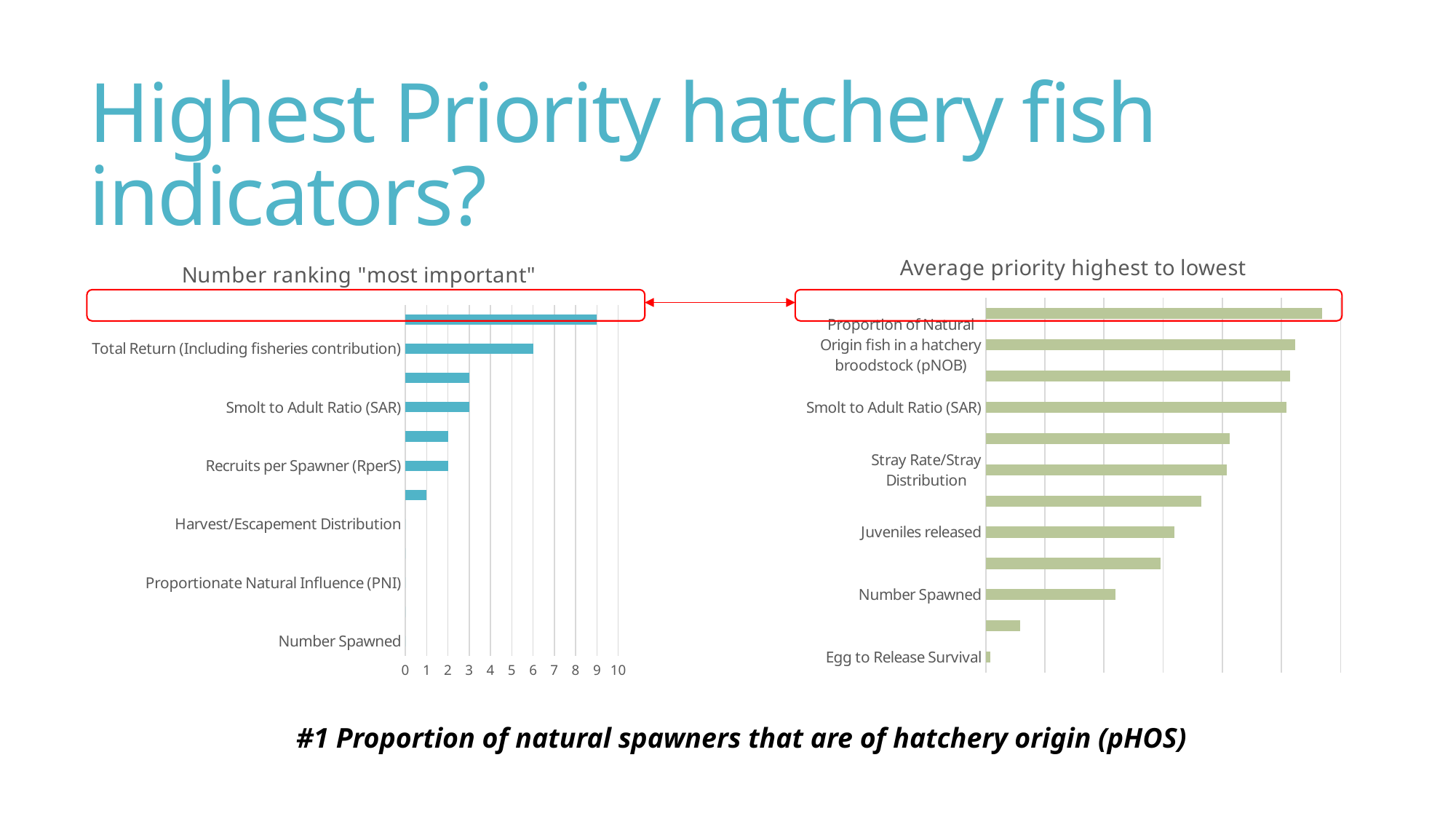
In the chart titled "Number ranking "most important"", what is the highest value shown on the x axis? 10 What kind of chart is the chart titled "Average priority highest to lowest"? bar chart In the chart titled "Average priority highest to lowest", which labeled category has the shortest bar? Egg to Release Survival What is the title of the chart on the right side of the slide? Average priority highest to lowest In the chart titled "Number ranking "most important"", what is the value for Recruits per Spawner (RperS)? 2 In the chart titled "Number ranking "most important"", what is the value for Total Return (Including fisheries contribution)? 6 In the chart titled "Number ranking "most important"", what is the difference between Total Return (Including fisheries contribution) and Smolt to Adult Ratio (SAR)? 3 In the chart titled "Average priority highest to lowest", which has the lowest value: Egg to Release Survival or Number Spawned? Egg to Release Survival In the chart titled "Average priority highest to lowest", which is larger: Smolt to Adult Ratio (SAR) or Juveniles released? Smolt to Adult Ratio (SAR) In the chart titled "Number ranking "most important"", what is the value for Smolt to Adult Ratio (SAR)? 3 In the chart titled "Number ranking "most important"", which is larger: Total Return (Including fisheries contribution) or Recruits per Spawner (RperS)? Total Return (Including fisheries contribution) In the chart titled "Number ranking "most important"", is the value for Total Return (Including fisheries contribution) greater or less than 5? greater